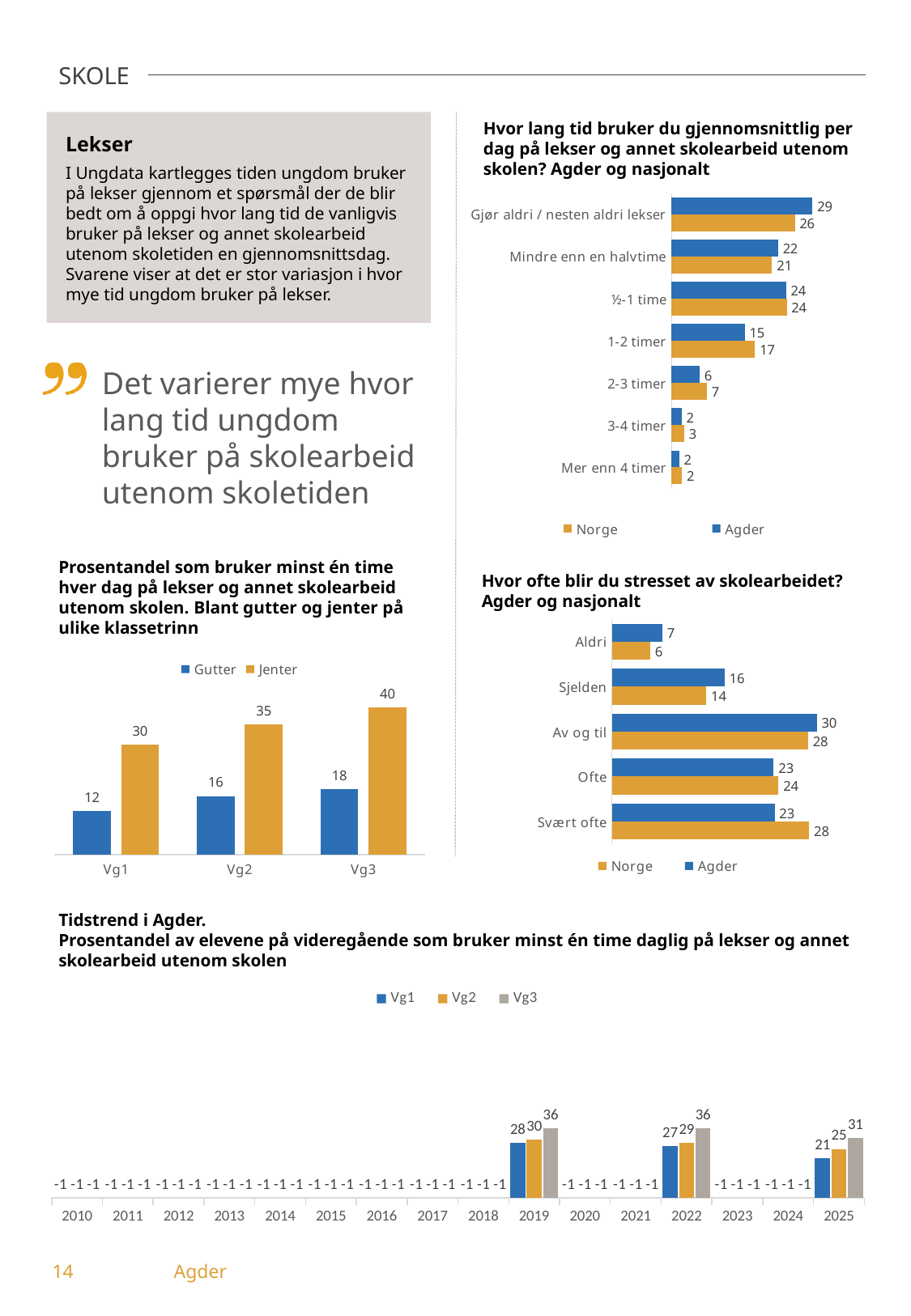
What kind of chart is 'Tidstrend i Agder'? bar chart In the chart 'Hvor lang tid bruker du gjennomsnittlig per dag på lekser og annet skolearbeid utenom skolen?', what is the Norge value for '1-2 timer'? 17 In the chart 'Prosentandel som bruker minst én time hver dag på lekser og annet skolearbeid utenom skolen', what is the value for Jenter at Vg3? 40 In the chart 'Hvor ofte blir du stresset av skolearbeidet?', what is the Norge value for 'Svært ofte'? 28 In the chart 'Hvor lang tid bruker du gjennomsnittlig per dag på lekser og annet skolearbeid utenom skolen?', how many categories are shown? 7 In the chart 'Prosentandel som bruker minst én time hver dag på lekser og annet skolearbeid utenom skolen', what is the difference between Jenter and Gutter at Vg1? 18 In the chart 'Hvor lang tid bruker du gjennomsnittlig per dag på lekser og annet skolearbeid utenom skolen?', what is the Agder value for 'Gjør aldri / nesten aldri lekser'? 29 In the chart 'Hvor ofte blir du stresset av skolearbeidet?', how many series does the legend list? 2 In the chart 'Tidstrend i Agder', what is the Vg3 value for 2025? 31 In the chart 'Hvor ofte blir du stresset av skolearbeidet?', which category has the highest Agder value? Av og til In the chart 'Hvor ofte blir du stresset av skolearbeidet?', which is larger for 'Sjelden': Agder or Norge? Agder In the chart 'Prosentandel som bruker minst én time hver dag på lekser og annet skolearbeid utenom skolen', do the Gutter values rise or fall from Vg1 to Vg3? rise